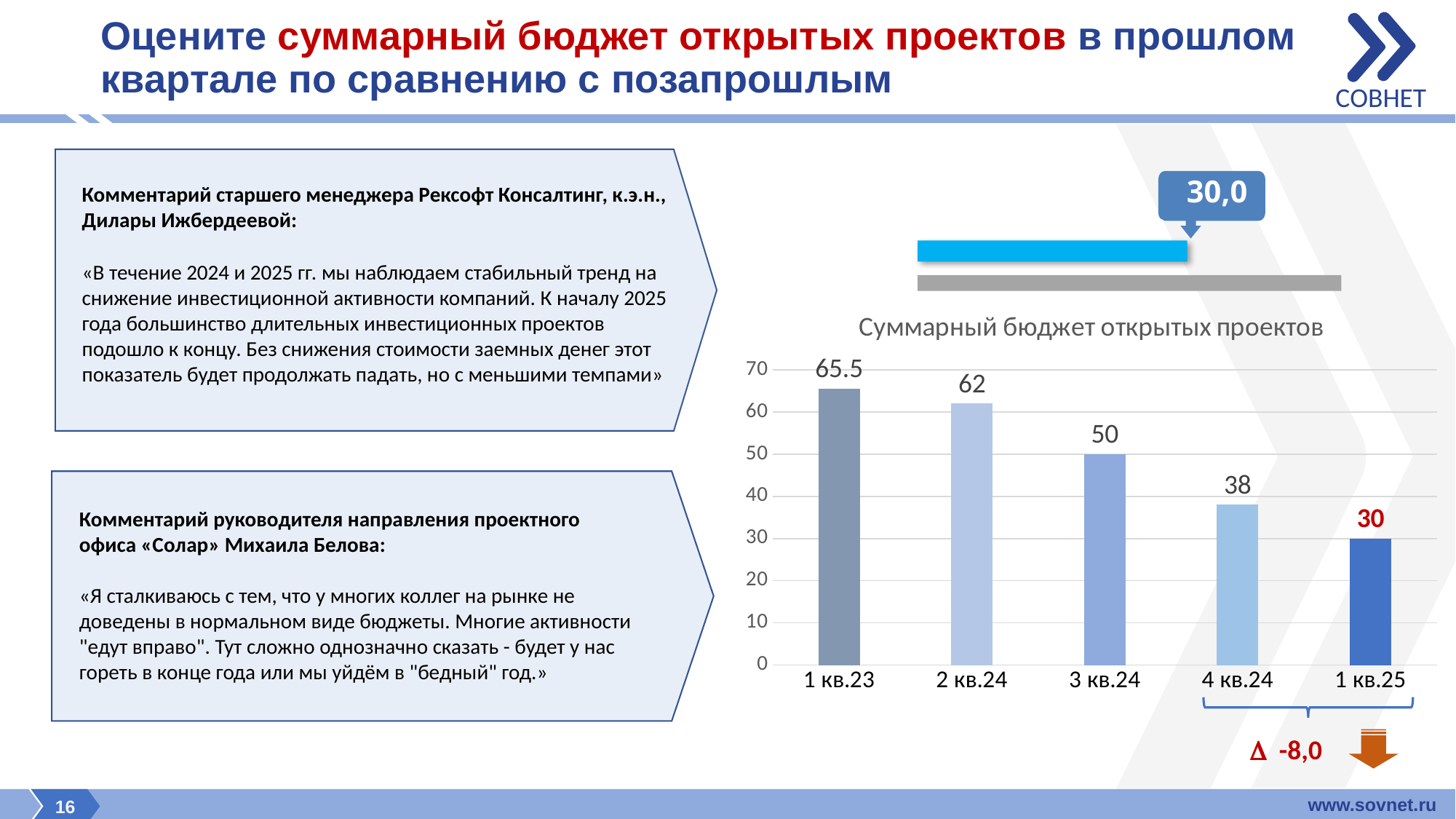
Which is larger, the value for 2 кв.24 or the value for 3 кв.24? 2 кв.24 How many categories are shown on the x axis of the chart? 5 Which category has the highest value in the chart? 1 кв.23 What is the value for 1 кв.25 in the chart? 30 What is the value for 1 кв.23 in the chart 'Суммарный бюджет открытых проектов'? 65.5 What kind of chart is shown on the slide? bar chart What is the title of the chart? Суммарный бюджет открытых проектов Which category has the lowest value in the chart? 1 кв.25 What is the difference between the values for 4 кв.24 and 1 кв.25? 8 Do the values rise or fall from 1 кв.23 to 1 кв.25? fall What is the value for 3 кв.24 in the chart? 50 What is the difference between the values for 1 кв.23 and 2 кв.24? 3.5